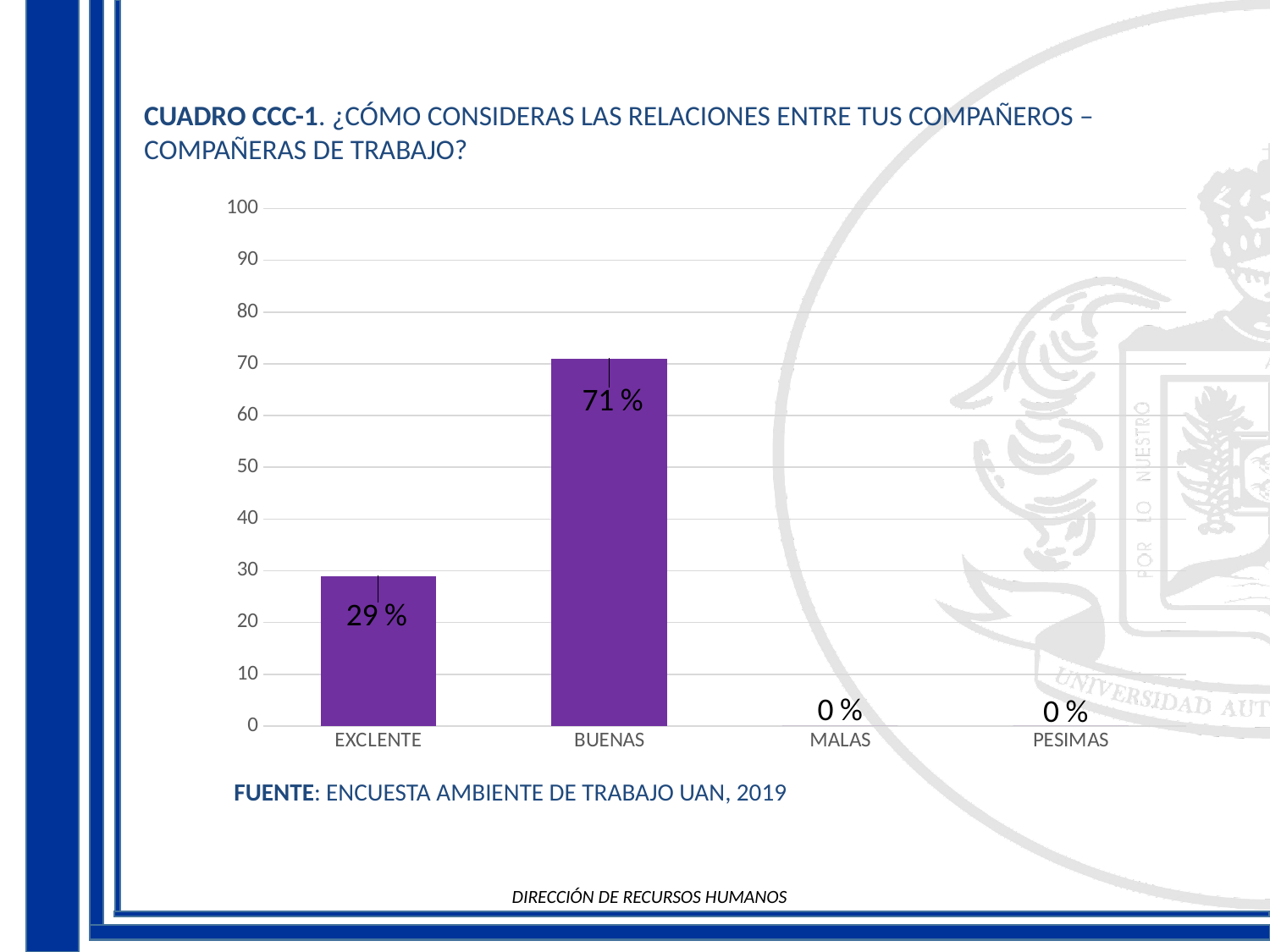
How many categories are shown on the x axis? 4 What is the difference between the values for BUENAS and EXCLENTE? 42 % What is the value for PESIMAS? 0 % What kind of chart is shown on the slide? Bar chart What is the value for BUENAS? 71 % Is the value for EXCLENTE greater or less than 40? less Which is larger, the value for EXCLENTE or the value for BUENAS? BUENAS What is the value for EXCLENTE? 29 % What is the source cited below the chart? ENCUESTA AMBIENTE DE TRABAJO UAN, 2019 What is the value for MALAS? 0 % Is the value for BUENAS greater or less than 60? greater Which category has the highest value? BUENAS